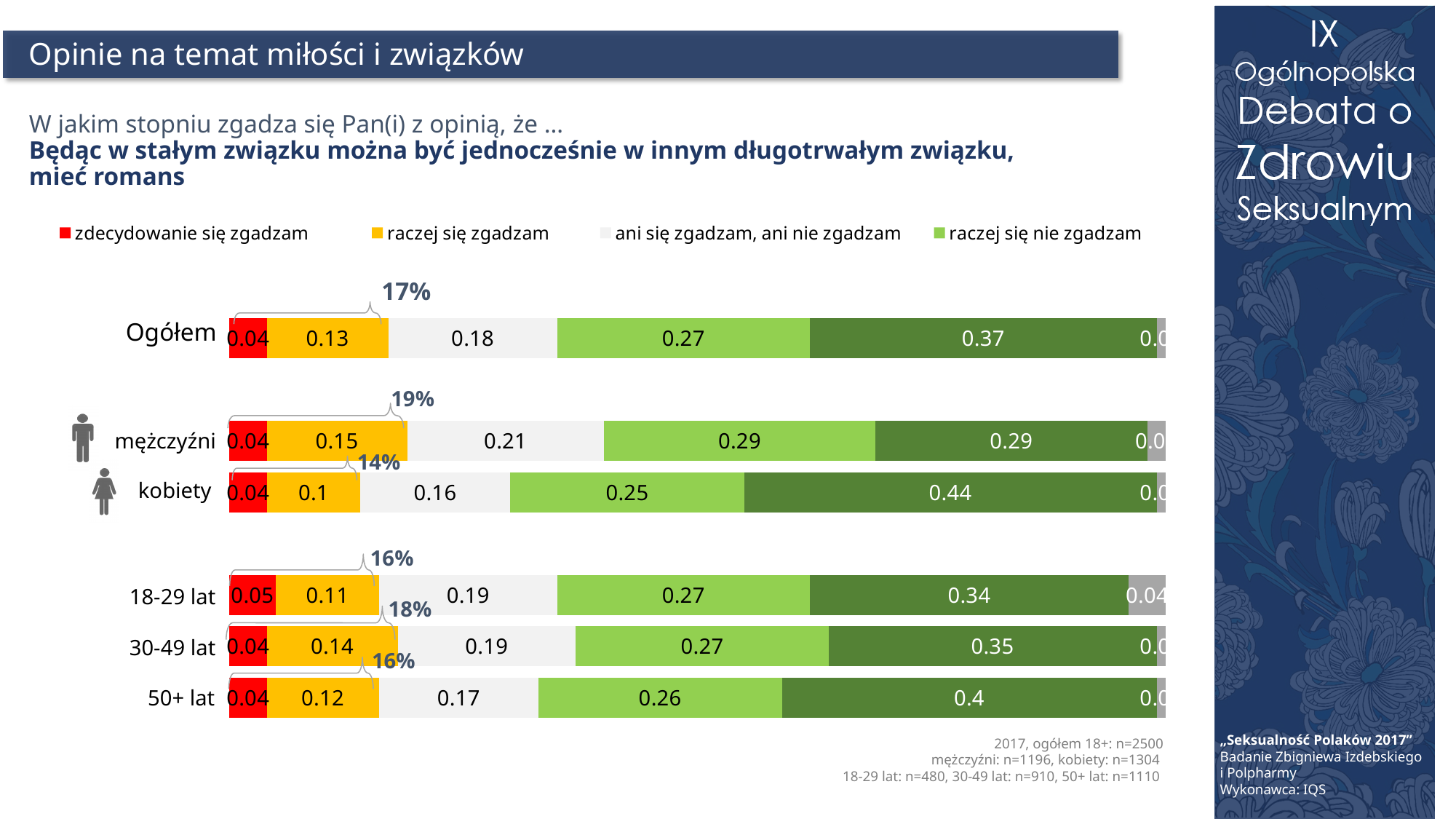
What is the value of the dark green segment for 50+ lat? 0.4 What combined percentage is shown above the bracket for the Ogółem bar? 17% What is the difference between the "raczej się nie zgadzam" values for mężczyźni and kobiety? 0.04 How many series does the legend list? 4 How many categories (bars) are shown in the chart? 6 Which category has the lowest value for "raczej się zgadzam"? kobiety Which is larger: the "raczej się zgadzam" value for 30-49 lat or for 50+ lat? 30-49 lat What is the value of "ani się zgadzam, ani nie zgadzam" for mężczyźni? 0.21 Which category has the highest value in the dark green segment? kobiety What is the value of "raczej się zgadzam" for kobiety? 0.1 What is the value of "zdecydowanie się zgadzam" for 18-29 lat? 0.05 What kind of chart is shown on the slide? stacked bar chart